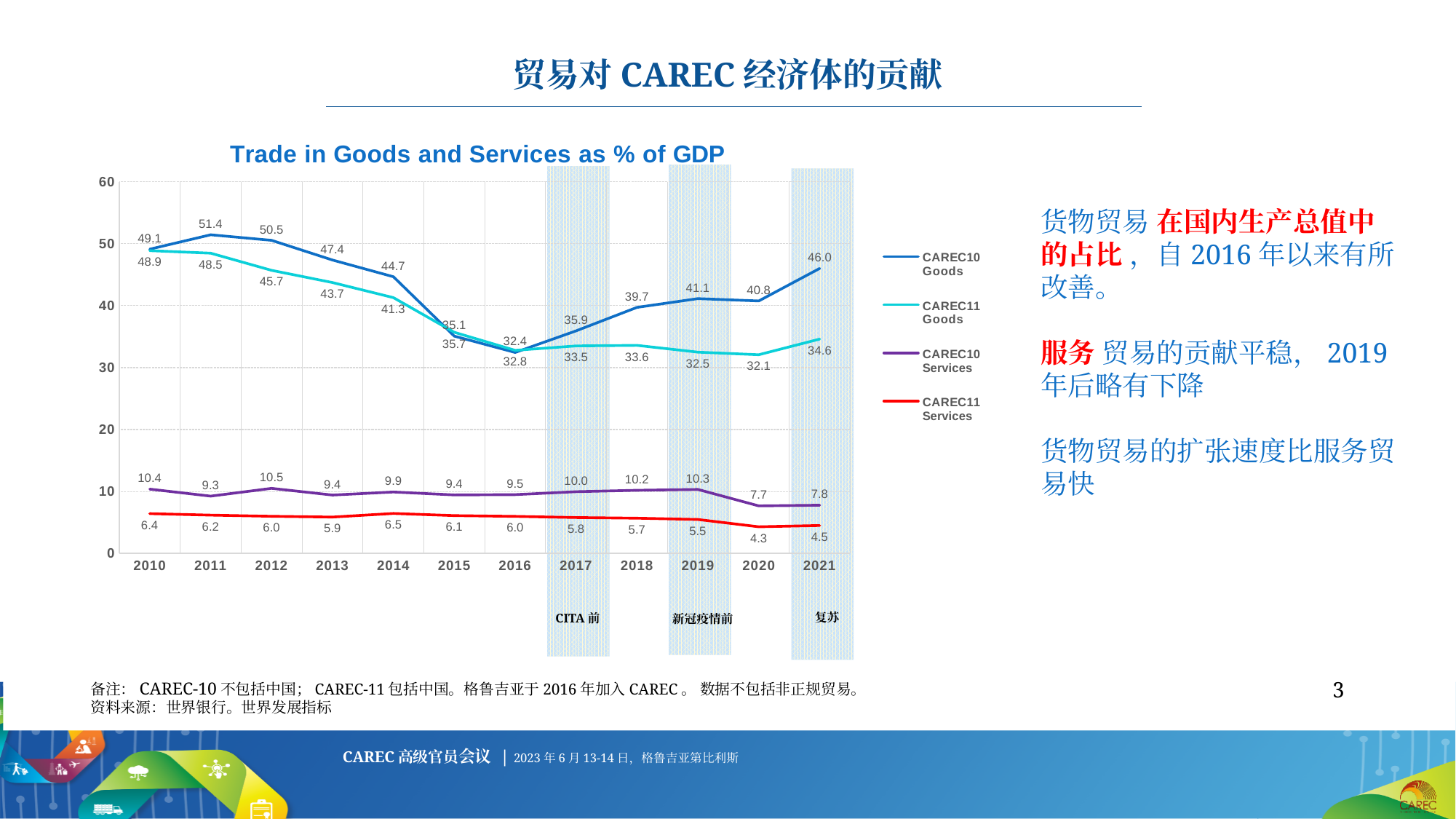
In 2019, which is larger: CAREC10 Goods or CAREC11 Goods? CAREC10 Goods What is the difference between the CAREC10 Goods value in 2011 and in 2016? 19.0 In which year is the CAREC11 Goods series at its lowest? 2020 What is the value for CAREC10 Goods in 2021? 46.0 In which year is the CAREC10 Goods series at its highest? 2011 What is the title of the chart? Trade in Goods and Services as % of GDP What is the value for CAREC10 Services in 2012? 10.5 How many years are shown on the x axis? 12 What is the value for CAREC11 Services in 2020? 4.3 What kind of chart is shown on the slide? Line chart Does the CAREC11 Services series rise or fall from 2010 to 2021? Fall How many series does the legend list? 4